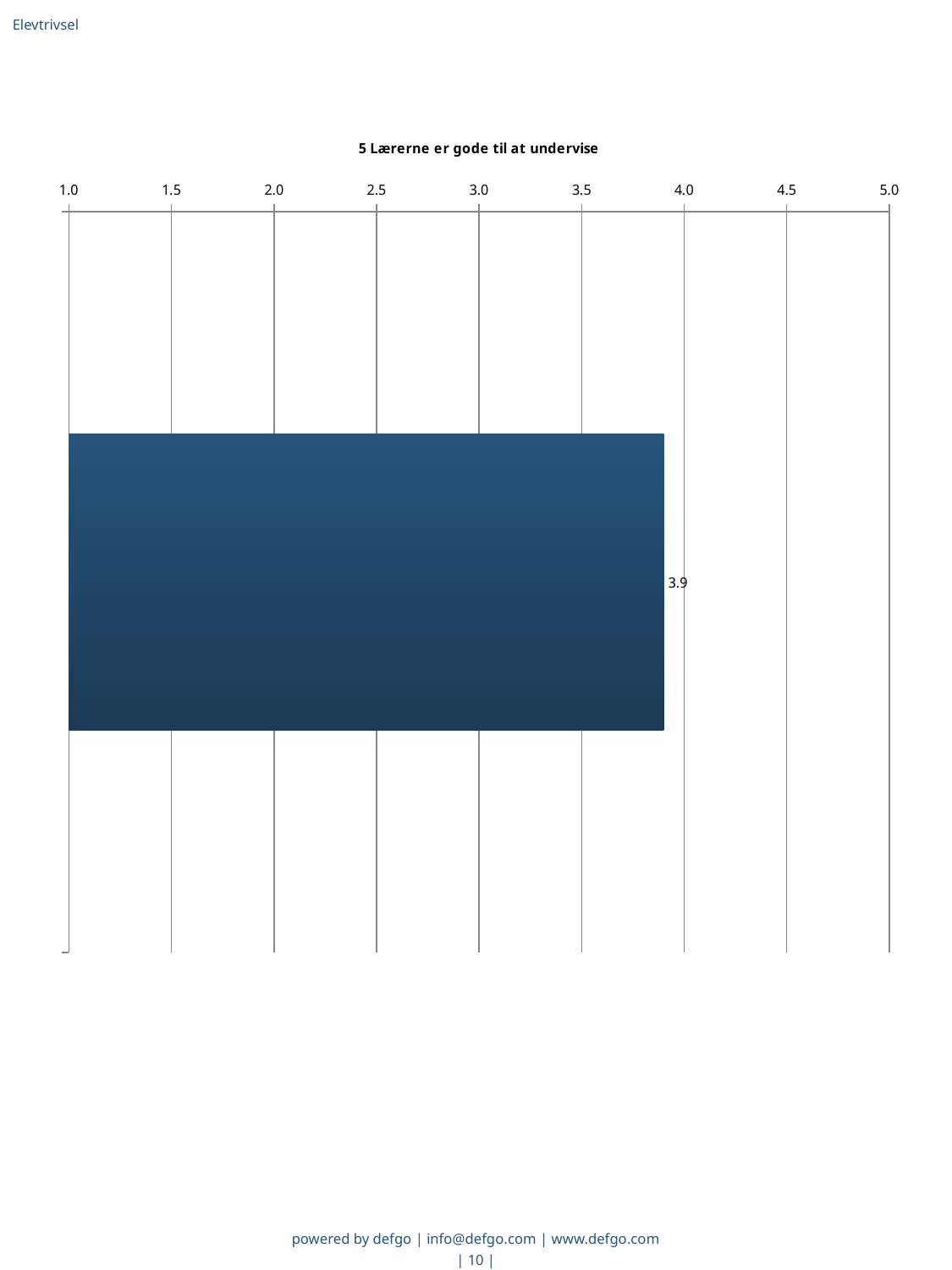
Is the value of the bar greater or less than 3.0? greater Is the value of the bar greater or less than 4.0? less What is the highest value shown on the chart's axis? 5.0 What is the title of the chart? 5 Lærerne er gode til at undervise What kind of chart is shown on the slide? bar chart How many bars are plotted in the chart? 1 What value is shown by the bar in the chart? 3.9 Is the value of the bar greater or less than 3.5? greater